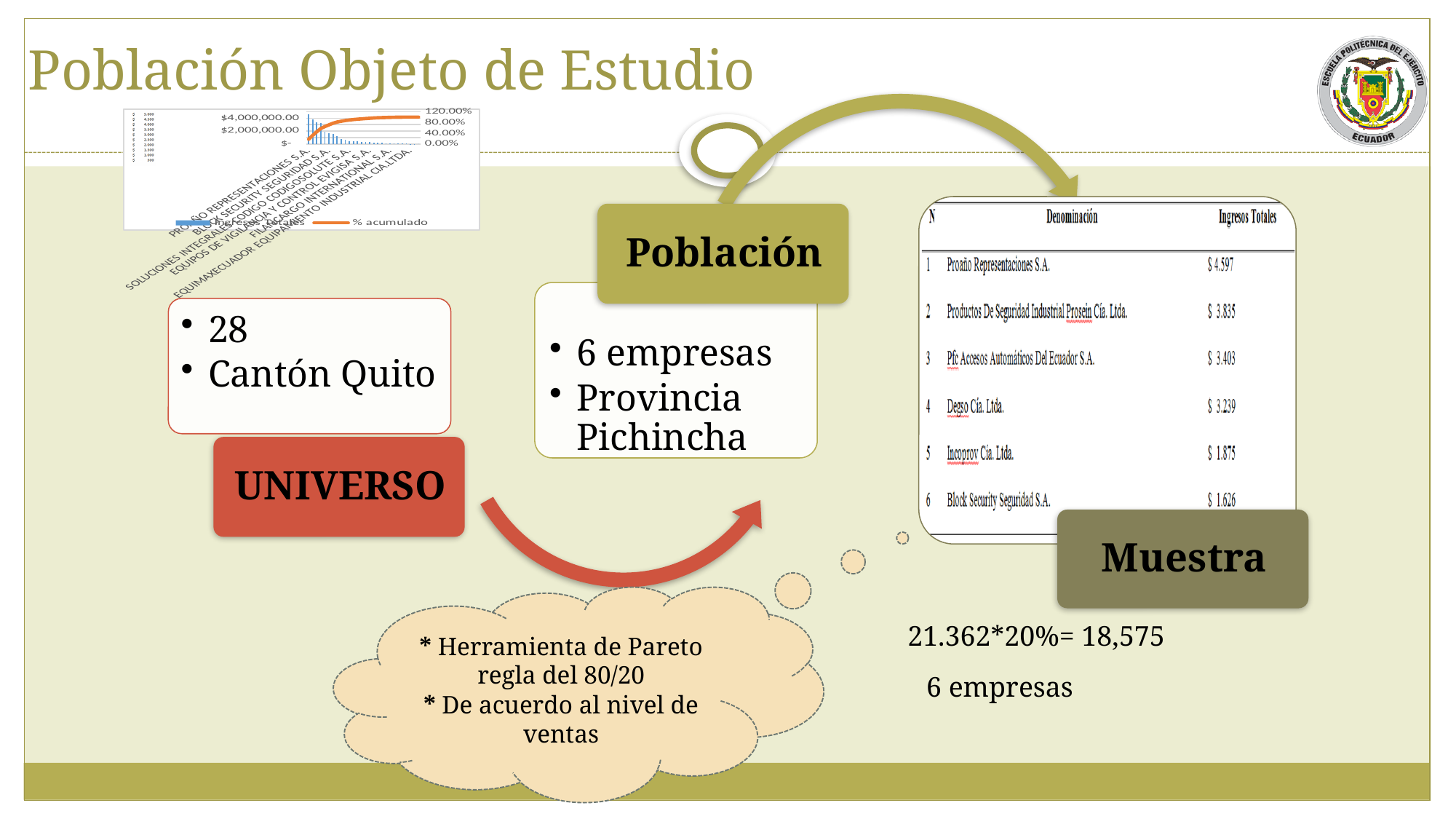
In the chart at the top left, do the blue bars get taller or shorter from left to right? Shorter In the chart at the top left, does the orange cumulative percentage line rise or fall from left to right? Rises In the chart at the top left, which category has the tallest blue bar? PROAÑO REPRESENTACIONES S.A. In the chart at the top left, is the final value of the orange cumulative line greater or less than 80.00%? greater In the chart at the top left, what is the highest value shown on the right-hand percentage axis? 120.00% In the chart at the top left, what does the orange line represent according to the legend? % acumulado What kind of chart is shown at the top left of the slide? A combined bar and line chart (Pareto chart)